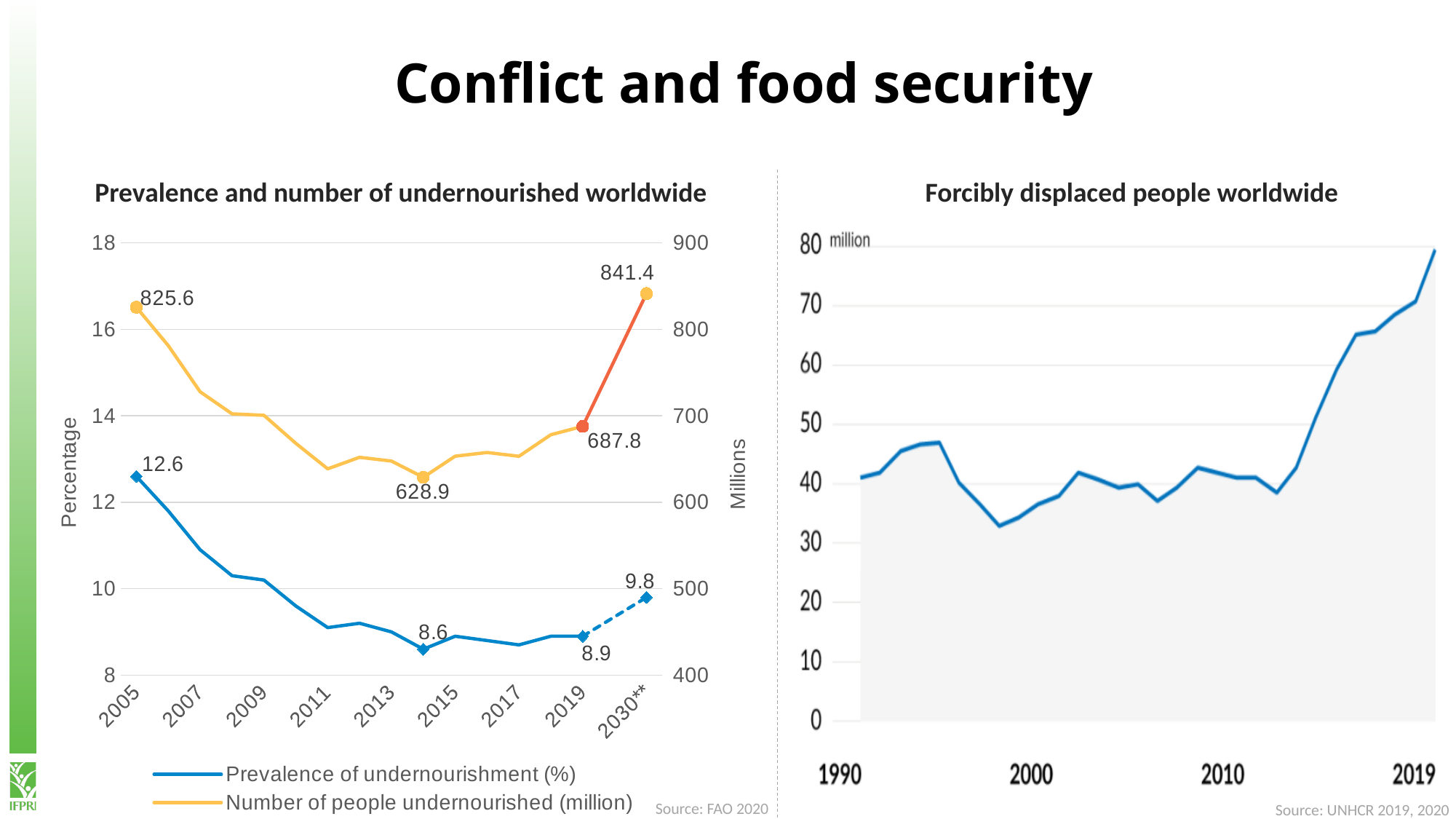
In the chart 'Forcibly displaced people worldwide', is the value for 2019 greater or less than 70 million? greater In the chart 'Forcibly displaced people worldwide', is the value for 2000 greater or less than 40 million? less In the chart 'Prevalence and number of undernourished worldwide', what is the difference between the 2005 prevalence of undernourishment (12.6) and the lowest labelled value (8.6)? 4.0 In the chart 'Prevalence and number of undernourished worldwide', what is the prevalence of undernourishment (%) in 2019? 8.9 How many series does the legend of the chart 'Prevalence and number of undernourished worldwide' list? 2 In the chart 'Prevalence and number of undernourished worldwide', which is larger: the number of people undernourished in 2005 or the projected number for 2030**? 2030** In the chart 'Prevalence and number of undernourished worldwide', by how much is the projected 2030** number of people undernourished (million) higher than the 2019 value of 687.8? 153.6 In the chart 'Forcibly displaced people worldwide', do the values rise or fall between 2010 and 2019? rise In the chart 'Prevalence and number of undernourished worldwide', what is the number of people undernourished (million) in 2005? 825.6 What kind of chart is 'Prevalence and number of undernourished worldwide'? Line chart In the chart 'Prevalence and number of undernourished worldwide', what is the prevalence of undernourishment (%) in 2005? 12.6 In the chart 'Prevalence and number of undernourished worldwide', what is the projected number of people undernourished (million) for 2030**? 841.4